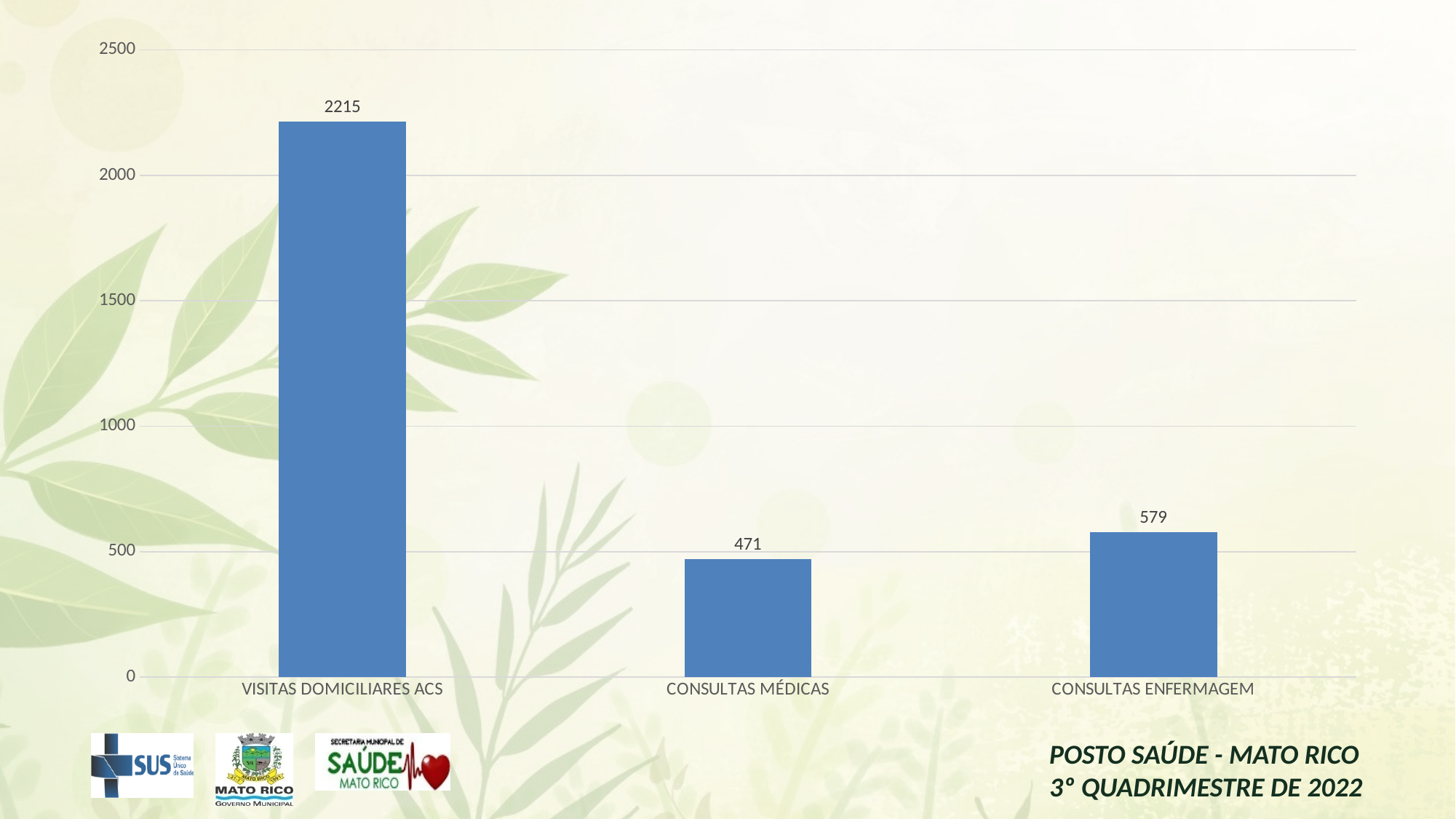
What is the difference between CONSULTAS ENFERMAGEM and CONSULTAS MÉDICAS? 108 What is the value for CONSULTAS ENFERMAGEM? 579 Is the value for CONSULTAS MÉDICAS greater or less than 500? less Which category has the lowest value? CONSULTAS MÉDICAS What is the value for VISITAS DOMICILIARES ACS? 2215 Which category has the highest value? VISITAS DOMICILIARES ACS Which is larger, CONSULTAS MÉDICAS or CONSULTAS ENFERMAGEM? CONSULTAS ENFERMAGEM How many categories are shown in the chart? 3 What kind of chart is shown on the slide? bar chart What is the difference between VISITAS DOMICILIARES ACS and CONSULTAS ENFERMAGEM? 1636 What is the value for CONSULTAS MÉDICAS? 471 What is the highest value shown on the vertical axis? 2500